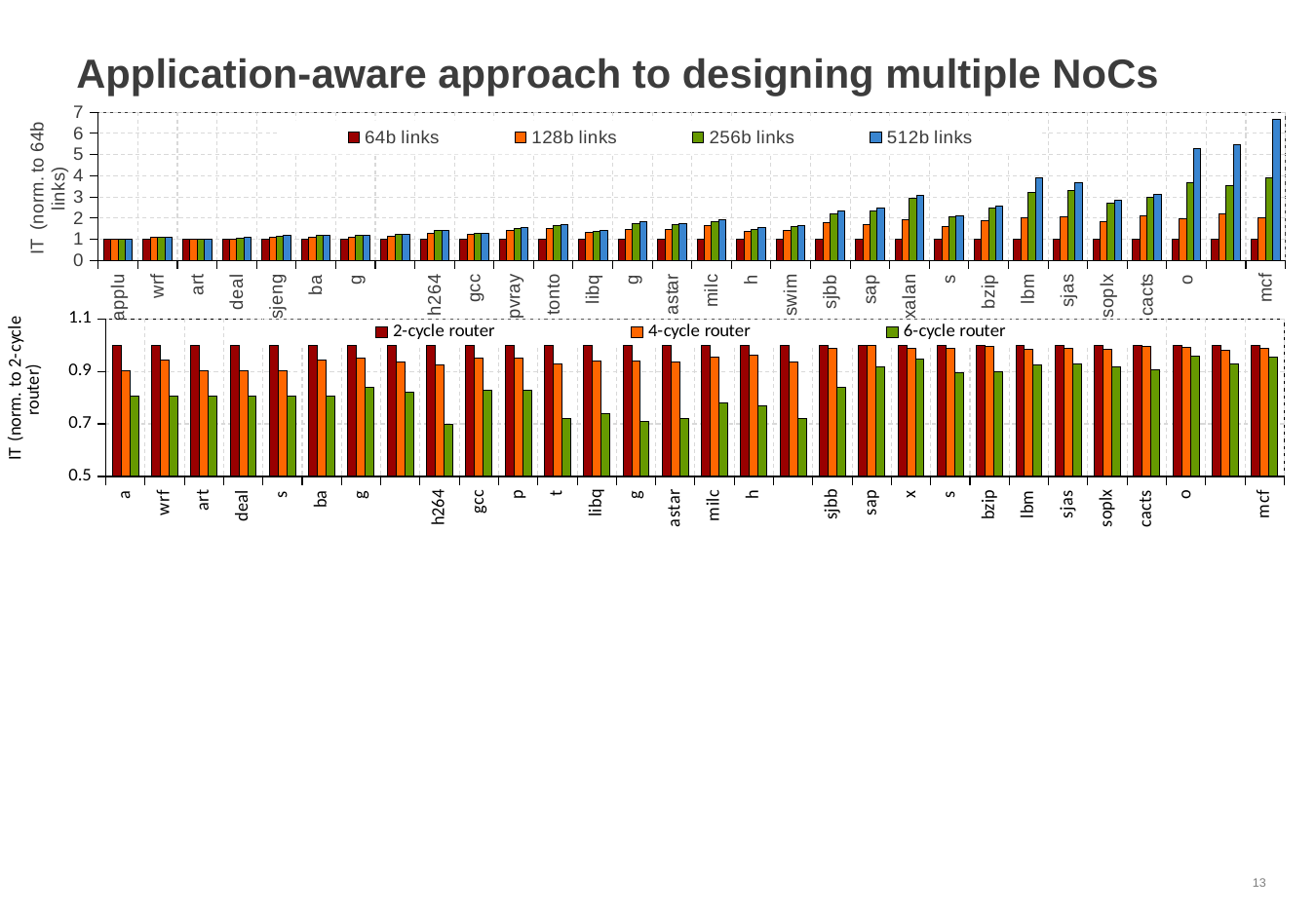
How many series does the legend of the bottom chart (IT norm. to 2-cycle router) list? 3 What kind of chart is the top chart (IT norm. to 64b links)? bar chart In the top chart, is the 512b links value for mcf greater or less than 6? greater In the top chart, is the 512b links value for lbm greater or less than 3? greater What are the legend entries of the bottom chart? 2-cycle router, 4-cycle router, 6-cycle router In the top chart, is the 512b links value for o greater or less than 5? greater In the top chart, which category has the highest value for 512b links? mcf In the top chart, which is larger for mcf: the 256b links value or the 512b links value? 512b links In the bottom chart, which is larger: the 6-cycle router value for h264 or for sjbb? sjbb How many series does the legend of the top chart list? 4 In the top chart, do the 512b links values generally rise or fall from left to right along the x axis? rise